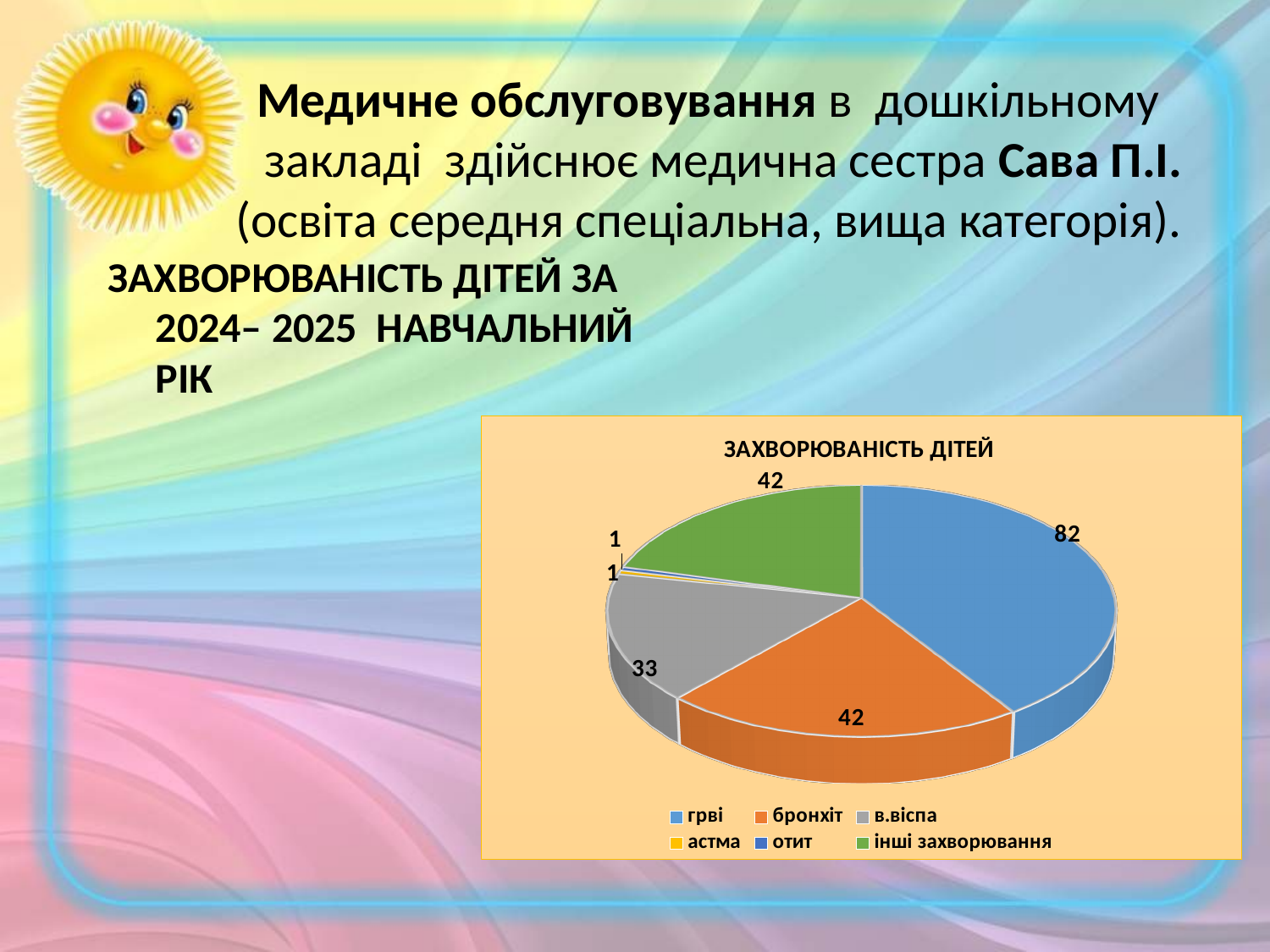
What is the value for в.віспа in the chart? 33 What is the value for грві in the chart? 82 What is the value for бронхіт in the chart? 42 What is the value for інші захворювання in the chart? 42 What is the title of the chart? ЗАХВОРЮВАНІСТЬ ДІТЕЙ How many categories does the legend of the chart list? 6 What kind of chart is shown on the slide? pie chart Which category has the largest slice in the chart? грві What is the difference between the values for бронхіт and в.віспа? 9 Which colour represents інші захворювання in the chart? green What is the difference between the values for грві and бронхіт? 40 Which is larger, the value for грві or the value for в.віспа? грві